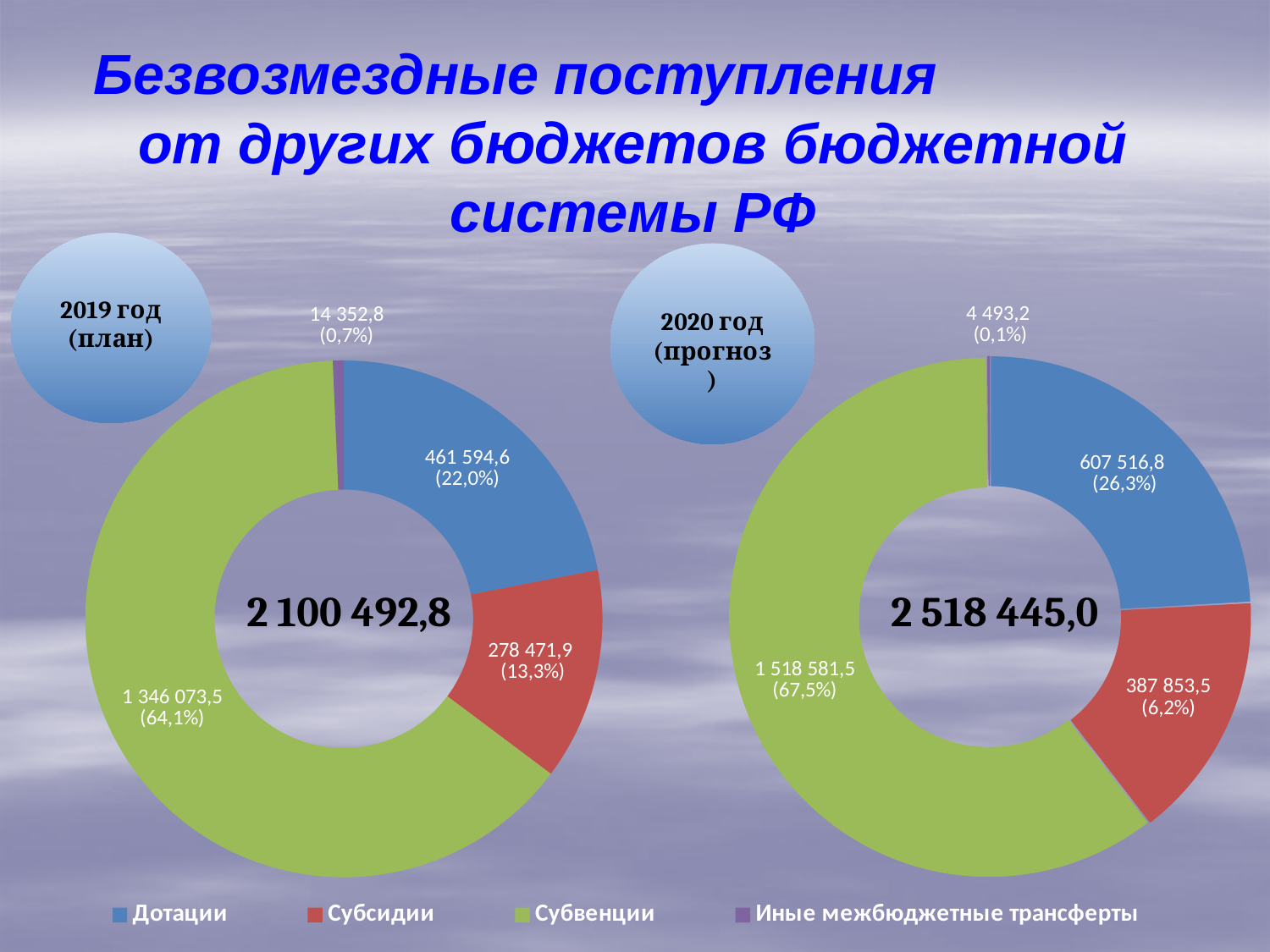
What type of chart is used on this slide? Doughnut (pie) chart In the 2020 год (прогноз) chart, what share of the total do Субвенции make up? 67,5% What is the total shown in the centre of the 2020 год (прогноз) chart? 2 518 445,0 In the 2019 год (план) chart, which is larger: Дотации or Субсидии? Дотации In the 2019 год (план) chart, what is the value for Субвенции? 1 346 073,5 Which colour represents Субсидии in the legend? Red In the 2020 год (прогноз) chart, what is the value for Дотации? 607 516,8 In the 2019 год (план) chart, what share of the total do Дотации make up? 22,0% In the 2020 год (прогноз) chart, which category has the largest value? Субвенции In the 2019 год (план) chart, which category has the smallest value? Иные межбюджетные трансферты How many categories does the legend list for the charts? 4 What is the total shown in the centre of the 2019 год (план) chart? 2 100 492,8